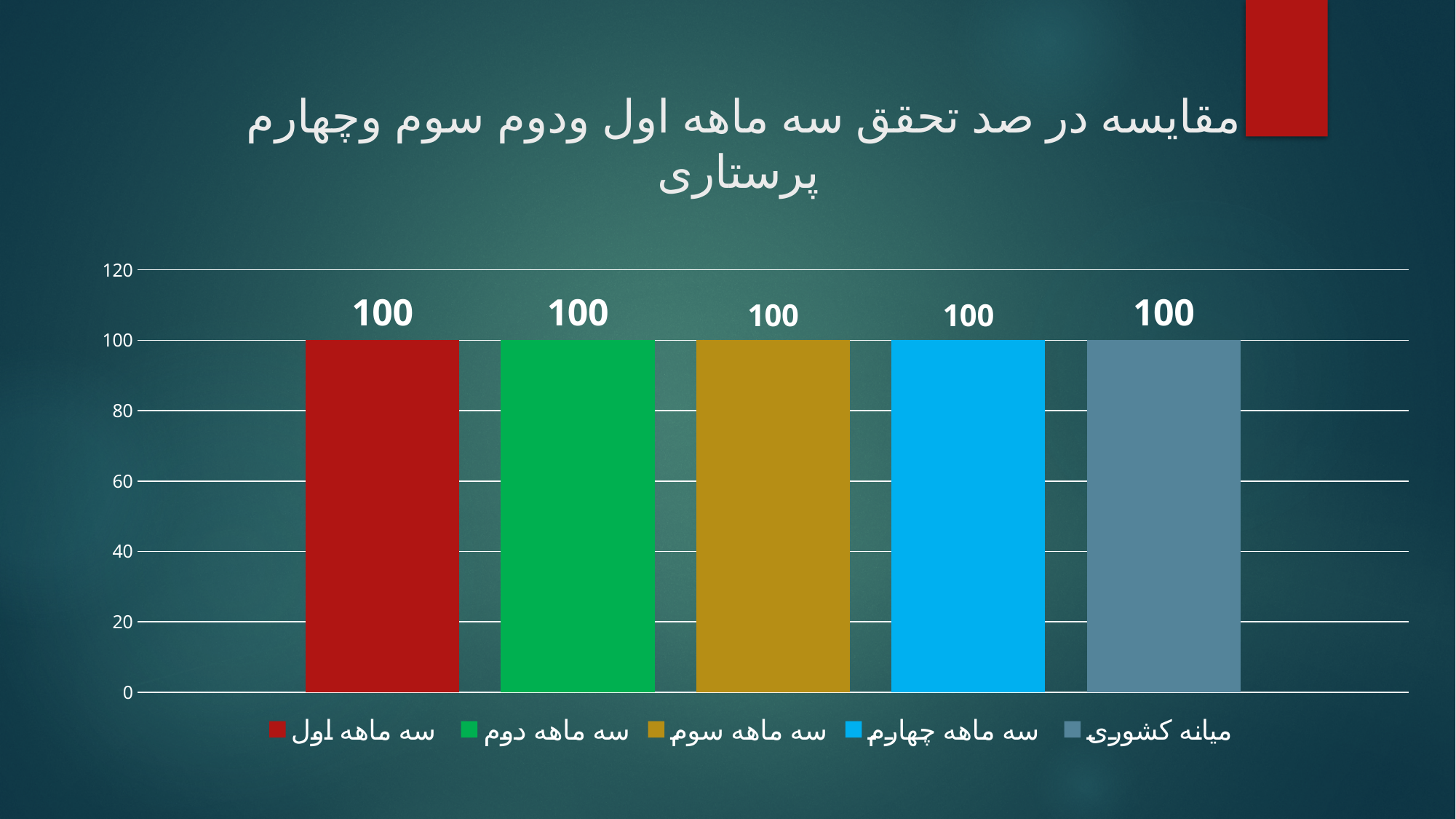
How many bars are plotted in the chart? 5 What is the value for سه ماهه اول? 100 Is the value for سه ماهه سوم greater or less than 80? greater What is the value for سه ماهه دوم? 100 What is the value for میانه کشوری? 100 What is the difference between the values for سه ماهه اول and میانه کشوری? 0 What is the value for سه ماهه سوم? 100 What type of chart is shown on the slide? bar chart What is the value for سه ماهه چهارم? 100 What colour is the bar for سه ماهه دوم? green What is the highest value shown on the vertical axis? 120 How many entries does the legend list? 5